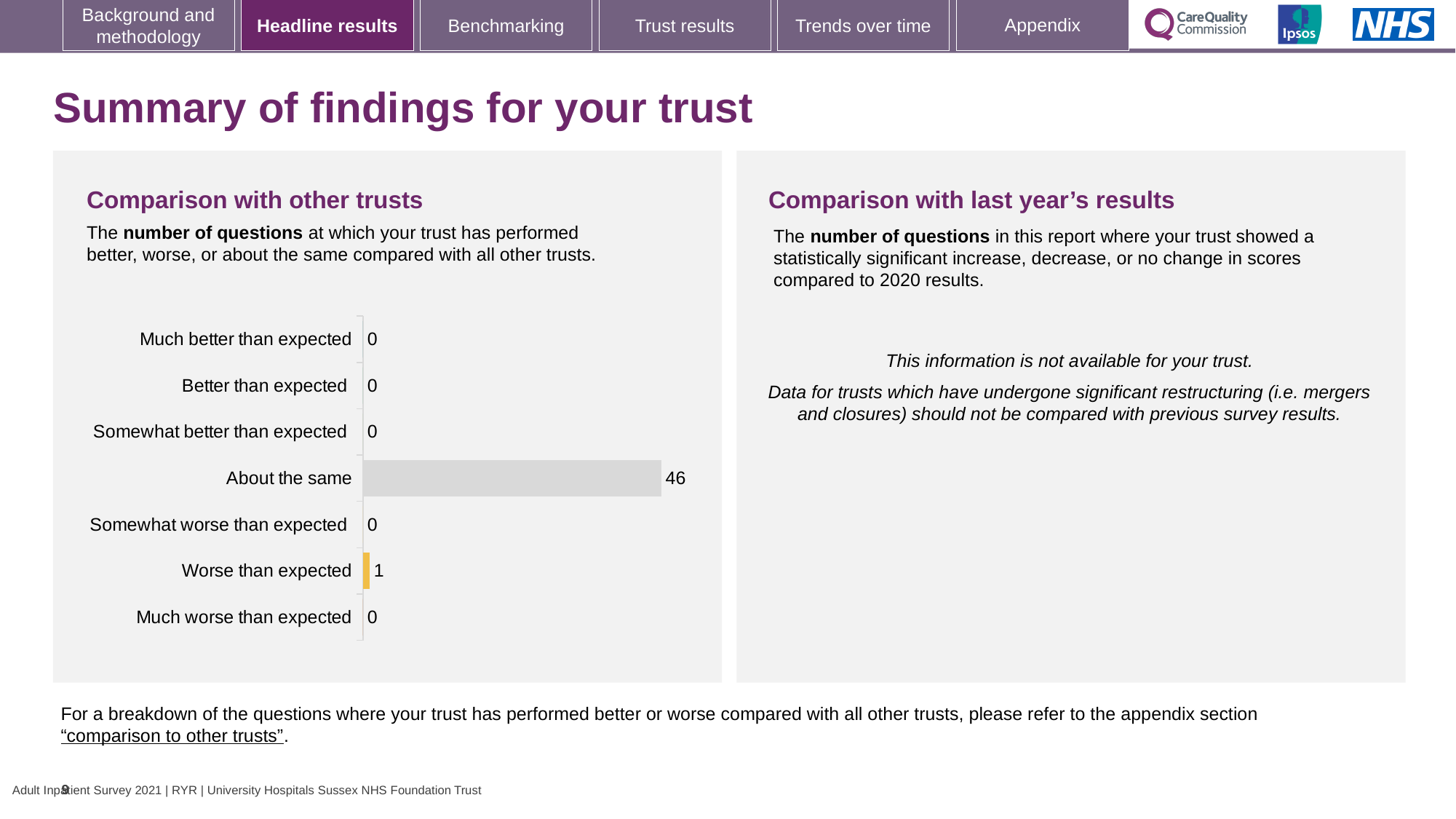
What type of chart is used in the 'Comparison with other trusts' section? Bar chart In the 'Comparison with other trusts' chart, which is larger: the value for 'Worse than expected' or the value for 'Better than expected'? Worse than expected In the 'Comparison with other trusts' chart, how many categories have a value of 0? 5 In the 'Comparison with other trusts' chart, what is the value for 'About the same'? 46 In the 'Comparison with other trusts' chart, what is the difference between the values for 'About the same' and 'Worse than expected'? 45 How many categories are shown in the 'Comparison with other trusts' chart? 7 What is the total of all values shown in the 'Comparison with other trusts' chart? 47 In the 'Comparison with other trusts' chart, what is the value for 'Worse than expected'? 1 In the 'Comparison with other trusts' chart, what is the value for 'Somewhat worse than expected'? 0 In the 'Comparison with other trusts' chart, what colour is the bar for 'Worse than expected'? Yellow In the 'Comparison with other trusts' chart, which category has the highest value? About the same In the 'Comparison with other trusts' chart, what is the value for 'Much better than expected'? 0